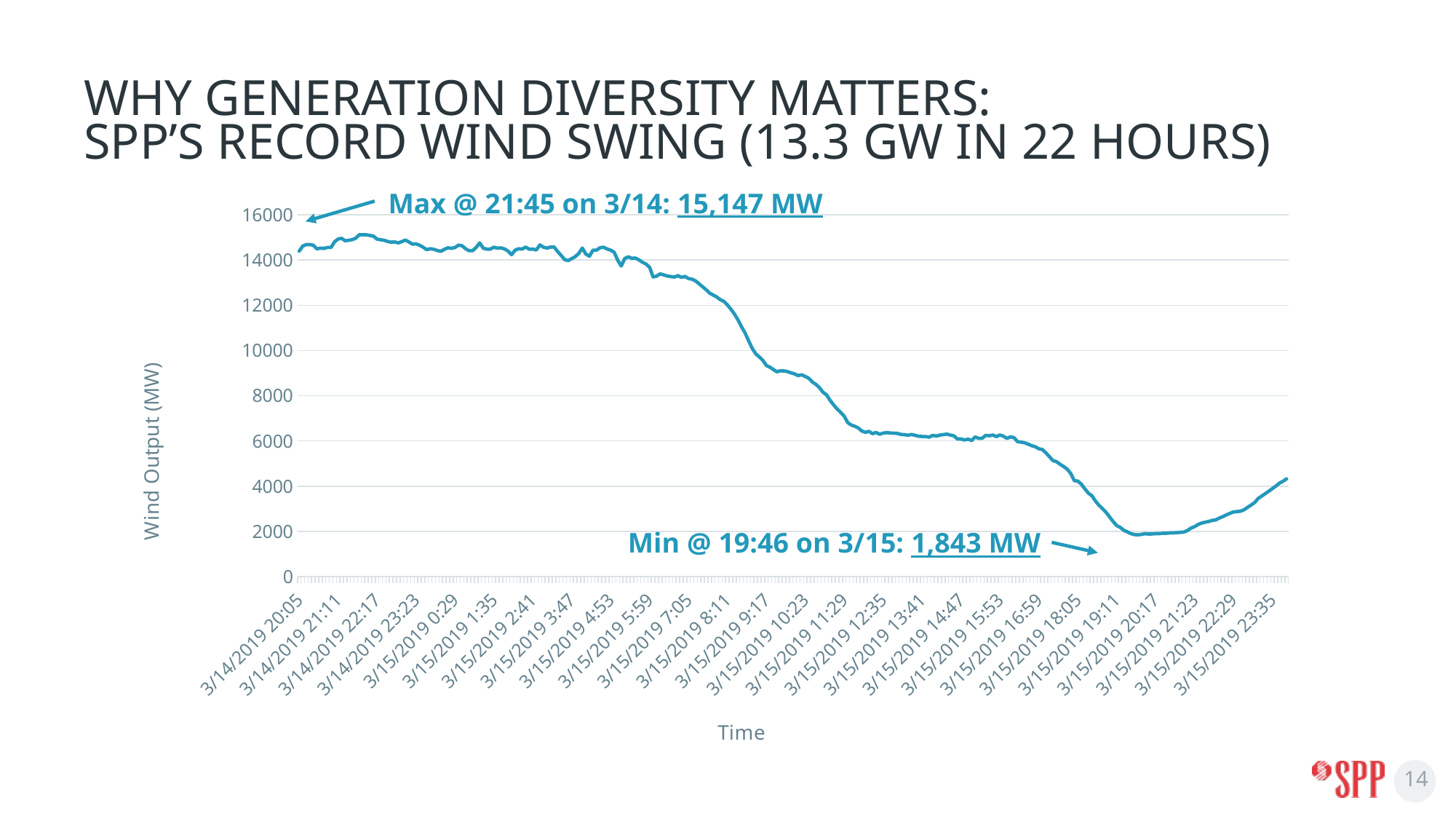
Which is larger: the wind output at 3/14/2019 20:05 or at 3/15/2019 23:35? 3/14/2019 20:05 At what time did the minimum wind output occur according to the chart annotation? 19:46 on 3/15 At what time did the maximum wind output occur according to the chart annotation? 21:45 on 3/14 What is the maximum wind output value annotated on the chart? 15,147 MW Is the wind output at 3/14/2019 22:17 greater or less than 14000 MW? greater What kind of chart is shown on the slide? Line chart Does wind output generally rise or fall from 3/14/2019 20:05 to 3/15/2019 19:11? Fall Is the wind output at 3/15/2019 20:17 greater or less than 4000 MW? less What is the minimum wind output value annotated on the chart? 1,843 MW Is the wind output at 3/15/2019 9:17 greater or less than 8000 MW? greater What is the label of the vertical axis of the chart? Wind Output (MW) What is the difference between the annotated maximum and minimum wind output values? 13,304 MW